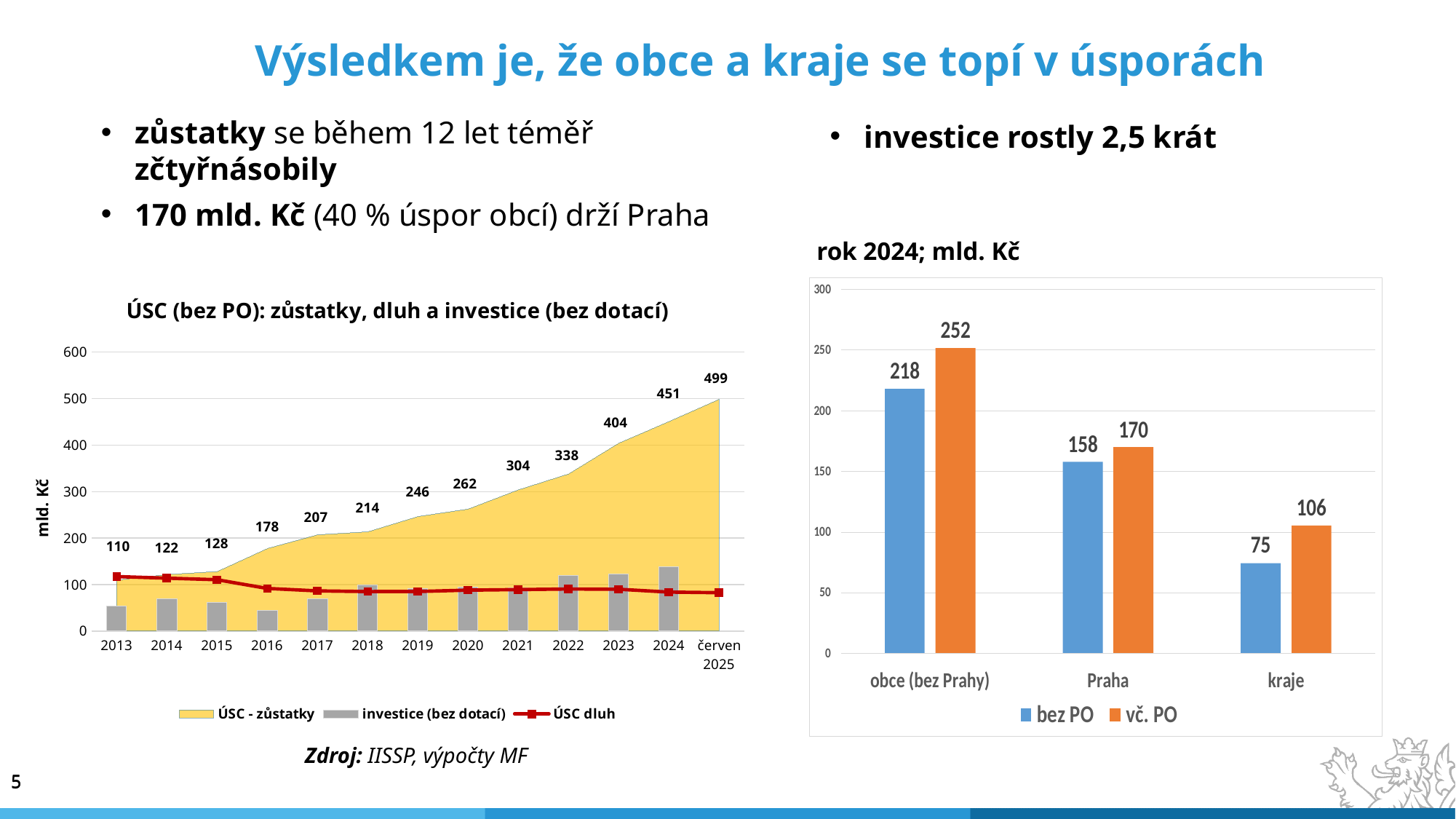
In the chart 'ÚSC (bez PO): zůstatky, dluh a investice (bez dotací)', is the investice (bez dotací) value for 2016 greater or less than 100? less In the chart 'rok 2024; mld. Kč', what is the value of bez PO for kraje? 75 In the chart 'ÚSC (bez PO): zůstatky, dluh a investice (bez dotací)', in which year is ÚSC - zůstatky lowest? 2013 In the chart 'rok 2024; mld. Kč', what is the difference between vč. PO and bez PO for obce (bez Prahy)? 34 In the chart 'ÚSC (bez PO): zůstatky, dluh a investice (bez dotací)', do the ÚSC - zůstatky values rise or fall from 2013 to červen 2025? rise In the chart 'ÚSC (bez PO): zůstatky, dluh a investice (bez dotací)', how many series does the legend list? 3 In the chart 'ÚSC (bez PO): zůstatky, dluh a investice (bez dotací)', what is the value of ÚSC - zůstatky for červen 2025? 499 In the chart 'ÚSC (bez PO): zůstatky, dluh a investice (bez dotací)', what is the value of ÚSC - zůstatky in 2020? 262 In the chart 'ÚSC (bez PO): zůstatky, dluh a investice (bez dotací)', by how much did ÚSC - zůstatky increase from 2023 to 2024? 47 In the chart 'rok 2024; mld. Kč', which category has the highest vč. PO value? obce (bez Prahy) In the chart 'rok 2024; mld. Kč', what is the value of vč. PO for Praha? 170 What kind of chart is the chart titled 'rok 2024; mld. Kč'? bar chart